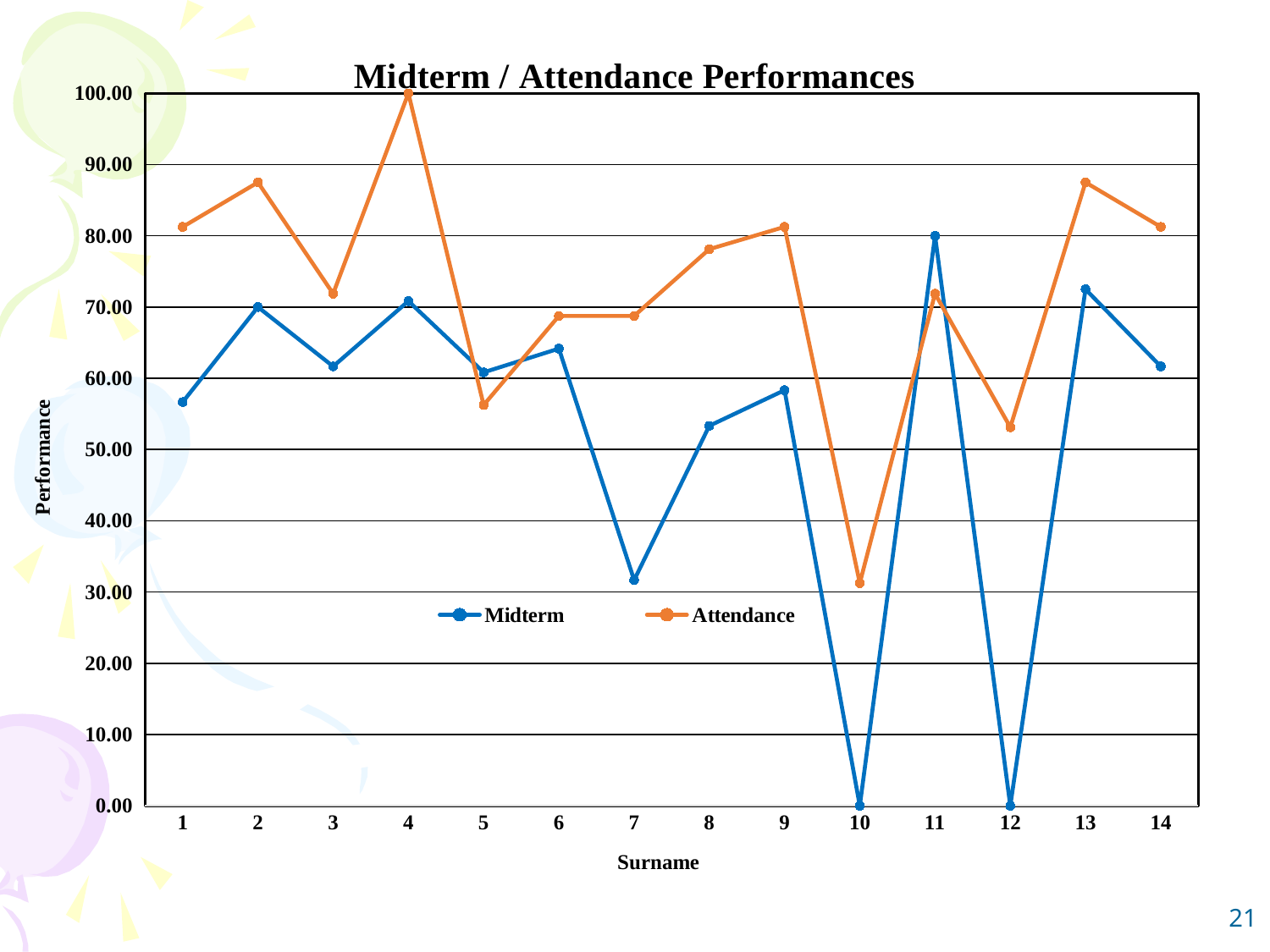
For category 11, which series has the larger value, Midterm or Attendance? Midterm Is the Midterm value for category 7 greater or less than 40.00? less Which category has the highest Midterm value? 11 What is the Midterm value for category 10? 0.00 How many categories are shown on the x axis? 14 Which category has the highest Attendance value? 4 What is the Attendance value for category 4? 100.00 How many series does the legend list? 2 What kind of chart is shown on the slide? line chart Is the Attendance value for category 2 greater or less than 80.00? greater What is the title of the chart? Midterm / Attendance Performances Which category has the lowest Attendance value? 10